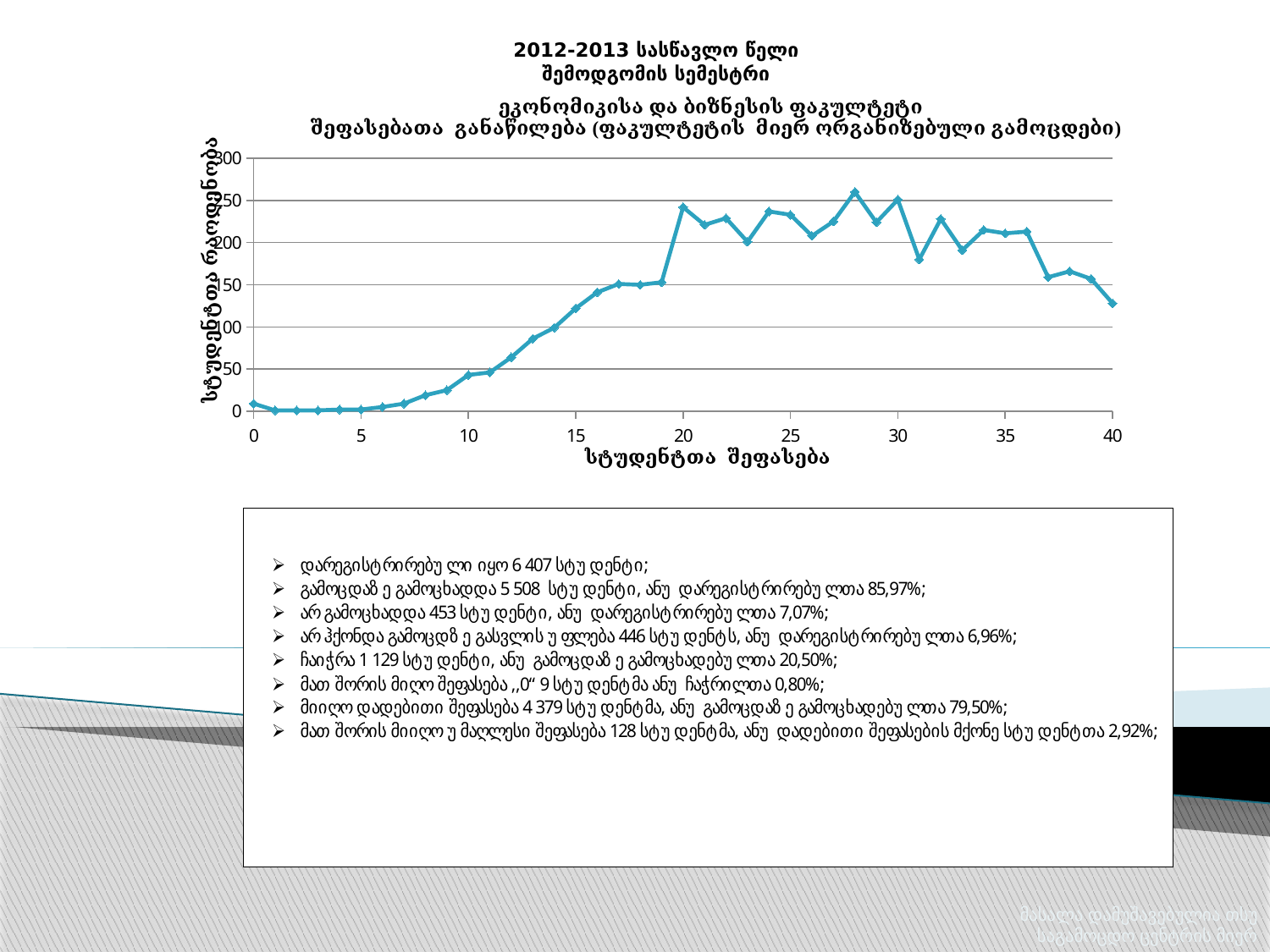
Is the value at grade 15 greater or less than 150? less Which is larger, the value at grade 20 or the value at grade 10? grade 20 Which is larger, the value at grade 30 or the value at grade 40? grade 30 What is the highest tick shown on the x axis? 40 What is the label of the x axis? სტუდენტთა შეფასება What kind of chart is shown on the slide? line chart Is the value at grade 30 greater or less than 200? greater Is the value at grade 20 greater or less than 200? greater Do the values rise or fall along the x axis between grade 0 and grade 20? rise